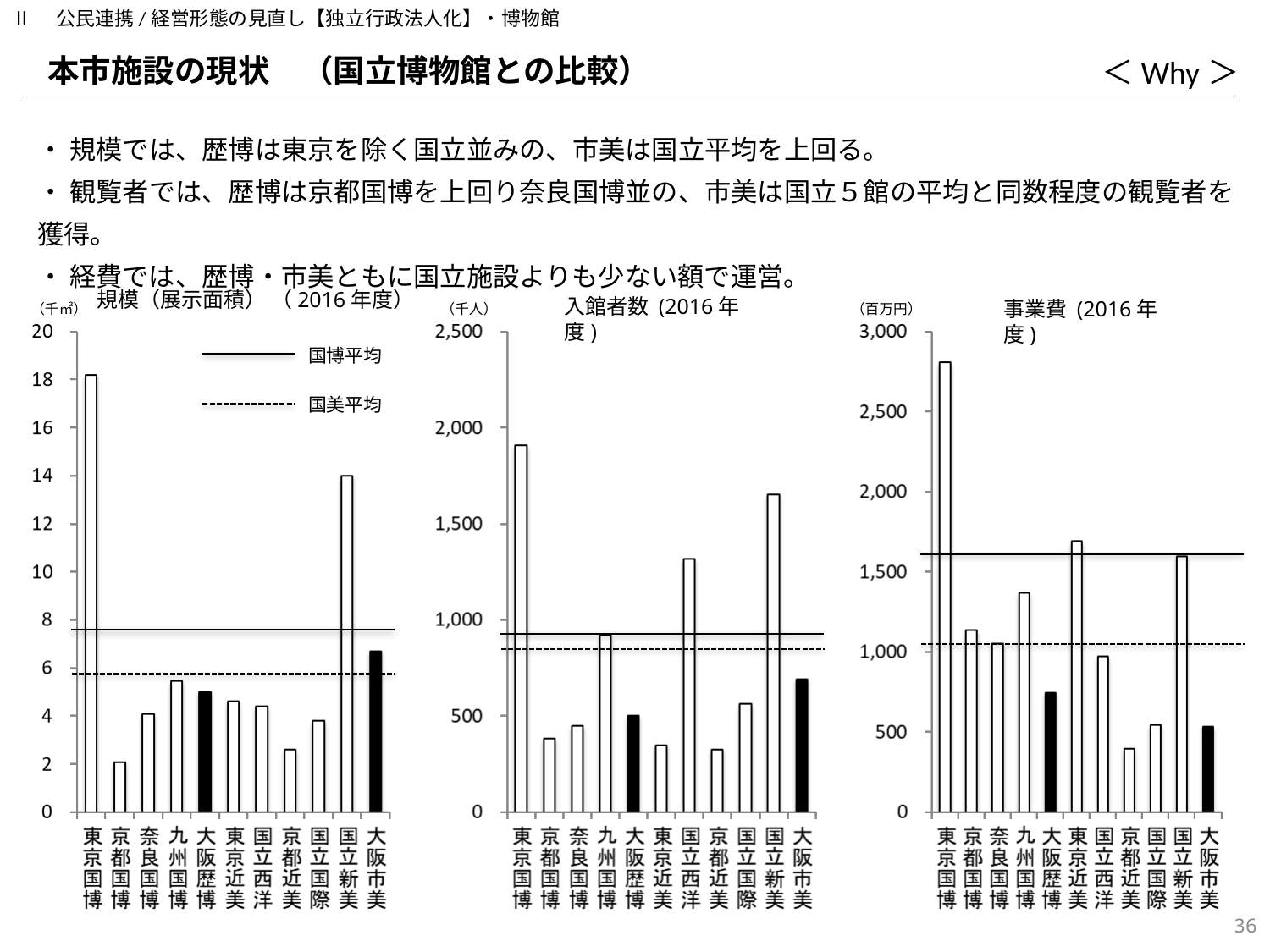
In the 事業費 chart, which museum has the lowest value? 京都近美 What two entries does the legend on the 規模（展示面積） chart list? 国博平均 and 国美平均 In the 事業費 chart, is the value for 大阪歴博 greater or less than 1,000? less How many museums (categories) are shown on the x axis of the 入館者数 chart? 11 In the 入館者数 chart, which is larger, the value for 国立新美 or 国立西洋? 国立新美 In the 規模（展示面積） chart, is the value for 国立新美 greater or less than 12? greater In the 規模（展示面積） chart, which museum has the lowest value? 京都国博 What kind of chart is the 規模（展示面積） chart on the left? bar chart In the 規模（展示面積） chart, which museum has the highest value? 東京国博 In the 入館者数 chart, which museum has the highest value? 東京国博 In the 規模（展示面積） chart, is the value for 大阪歴博 greater or less than 6? less